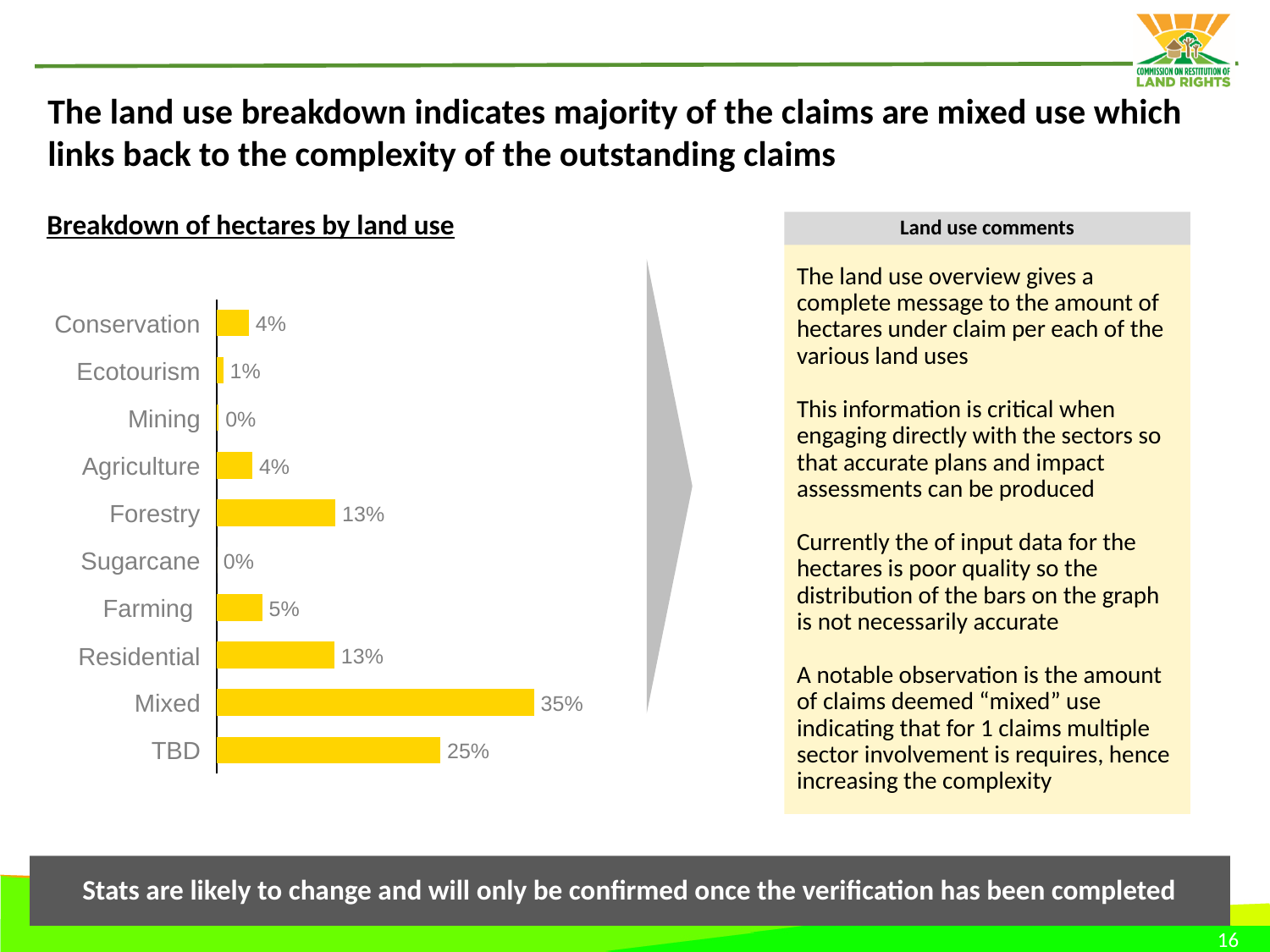
What is the value shown for TBD? 25% What percentage of hectares is shown for Mixed land use? 35% What type of chart is used to show the breakdown of hectares by land use? Bar chart What is the difference between the values for Mixed and TBD? 10% What is the value shown for Ecotourism? 1% Which is larger, the value for Farming or the value for Conservation? Farming What is the value shown for Forestry? 13% Which land use category has the highest share of hectares? Mixed How many land use categories are shown in the chart? 10 What is the title of the chart? Breakdown of hectares by land use What is the difference between the values for Forestry and Farming? 8% Which is larger, the value for Residential or the value for Agriculture? Residential